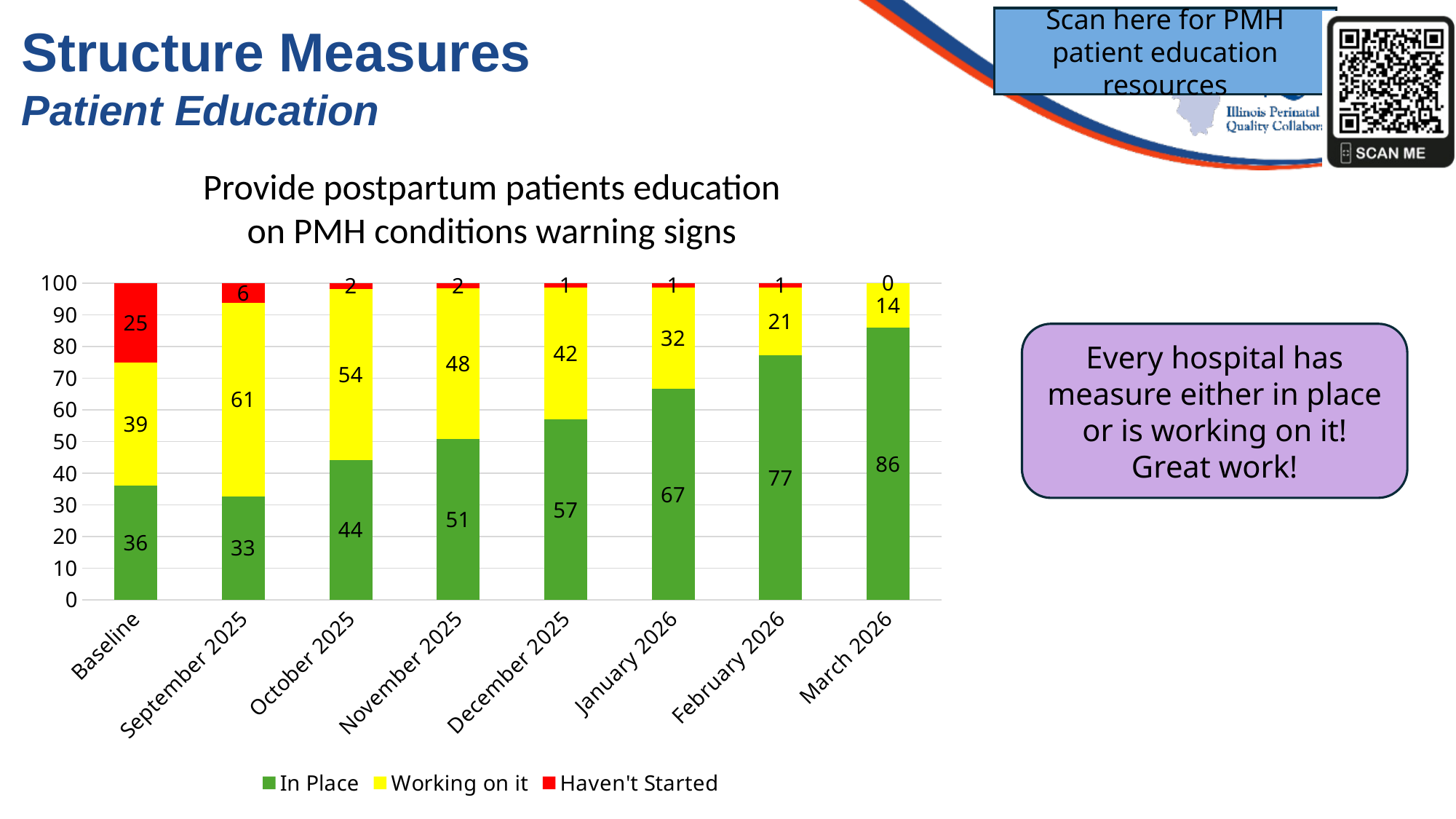
What is the 'In Place' value for March 2026? 86 Which category has the lowest 'In Place' value? September 2025 Which is larger, the 'Working on it' value for October 2025 or for January 2026? October 2025 What is the difference between the 'In Place' values for March 2026 and Baseline? 50 Does the 'In Place' value rise or fall from September 2025 to March 2026? Rise What colour represents the 'Haven't Started' series? Red What is the 'Working on it' value for September 2025? 61 What is the 'Haven't Started' value for Baseline? 25 How many series does the legend list? 3 Which category has the highest 'In Place' value? March 2026 What kind of chart is shown on the slide? Stacked bar chart How many categories are shown on the x axis? 8